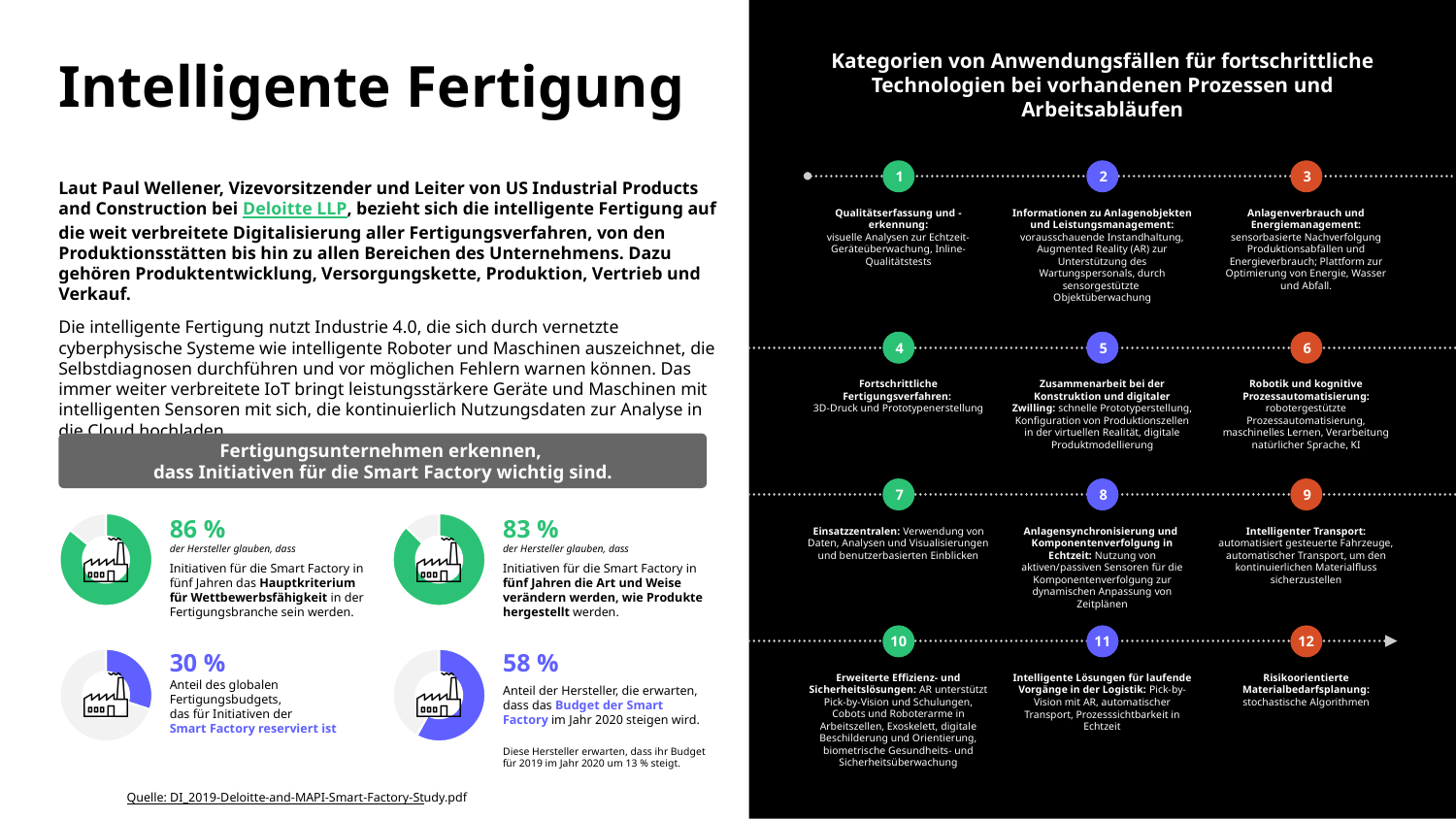
What is the difference between the percentage in the top-left donut chart (86 %) and the top-right donut chart (83 %)? 3 % Which of the four donut charts shows the lowest percentage? Bottom-left (30 %) Which is larger: the percentage in the bottom-left donut chart or the bottom-right donut chart? Bottom-right (58 %) In the top-left donut chart, what percentage of manufacturers believe that Smart Factory initiatives will be the main criterion for competitiveness in five years? 86 % Which of the four donut charts shows the highest percentage? Top-left (86 %) What is the difference between the percentage in the bottom-right donut chart (58 %) and the bottom-left donut chart (30 %)? 28 % In the bottom-left donut chart, what share of global manufacturing budgets is reserved for Smart Factory initiatives? 30 % In the bottom-right donut chart, what percentage of manufacturers expect the Smart Factory budget to rise in 2020? 58 % What kind of chart is used to show the four percentages under the heading 'Fertigungsunternehmen erkennen, dass Initiativen für die Smart Factory wichtig sind'? Donut (pie) chart How many donut charts are shown on the slide? 4 What colour is used for the filled portion of the two bottom donut charts? Blue In the top-right donut chart, what percentage of manufacturers believe that Smart Factory initiatives will change the way products are made in five years? 83 %